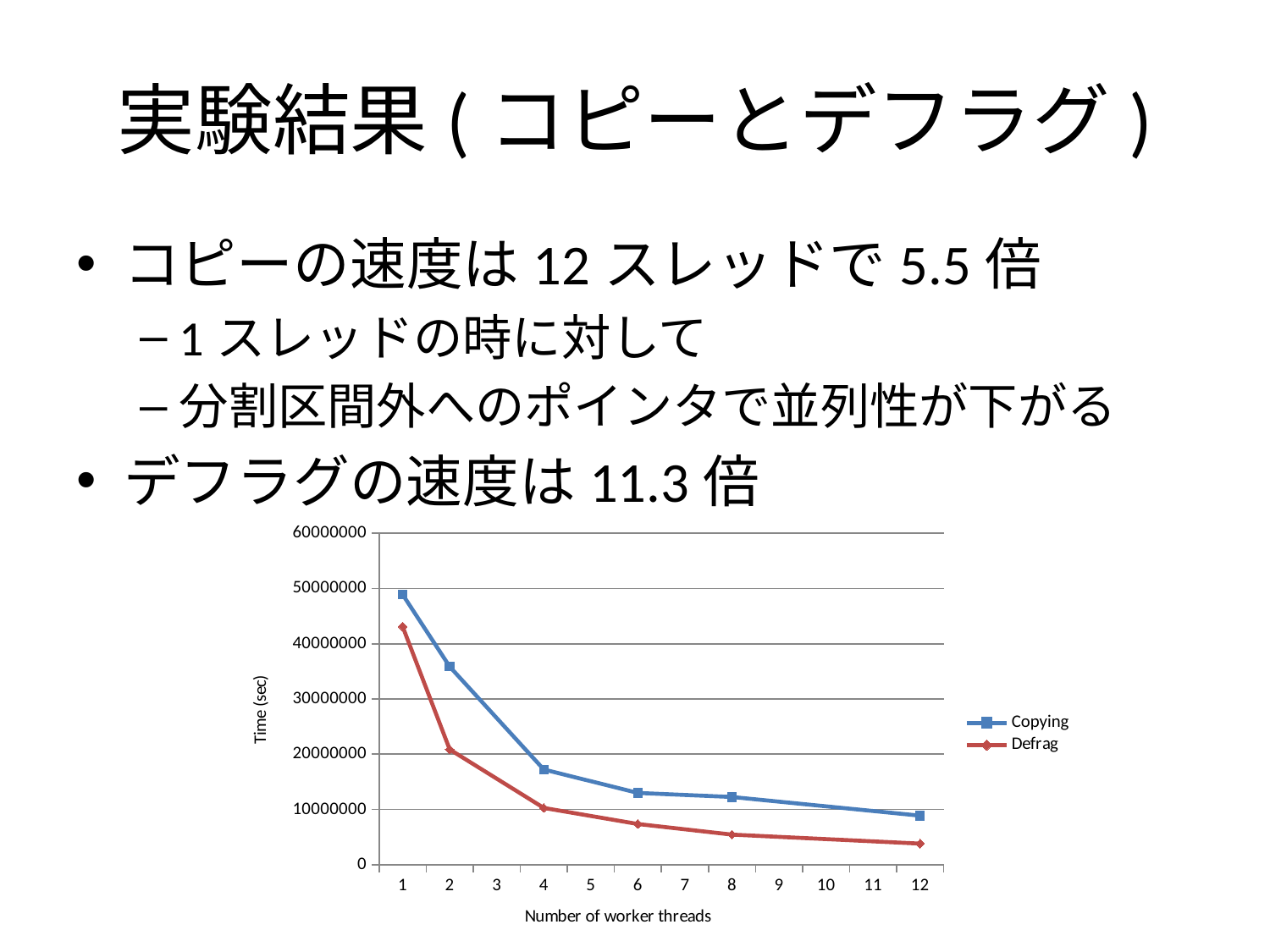
For the Copying series, at which number of worker threads is the time highest? 1 How many data points are plotted for the Copying series? 6 Do the Defrag values rise or fall as the number of worker threads increases? fall Is the Copying value at 12 worker threads greater or less than 20000000? less Is the Defrag value at 2 worker threads greater or less than 30000000? less At 4 worker threads, which series has the larger time, Copying or Defrag? Copying What kind of chart is shown on the slide? line chart Do the Copying values rise or fall as the number of worker threads increases? fall How many series does the chart legend list? 2 Is the Copying value at 1 worker thread greater or less than 40000000? greater What are the names of the two series in the legend? Copying and Defrag What is the label of the x axis? Number of worker threads